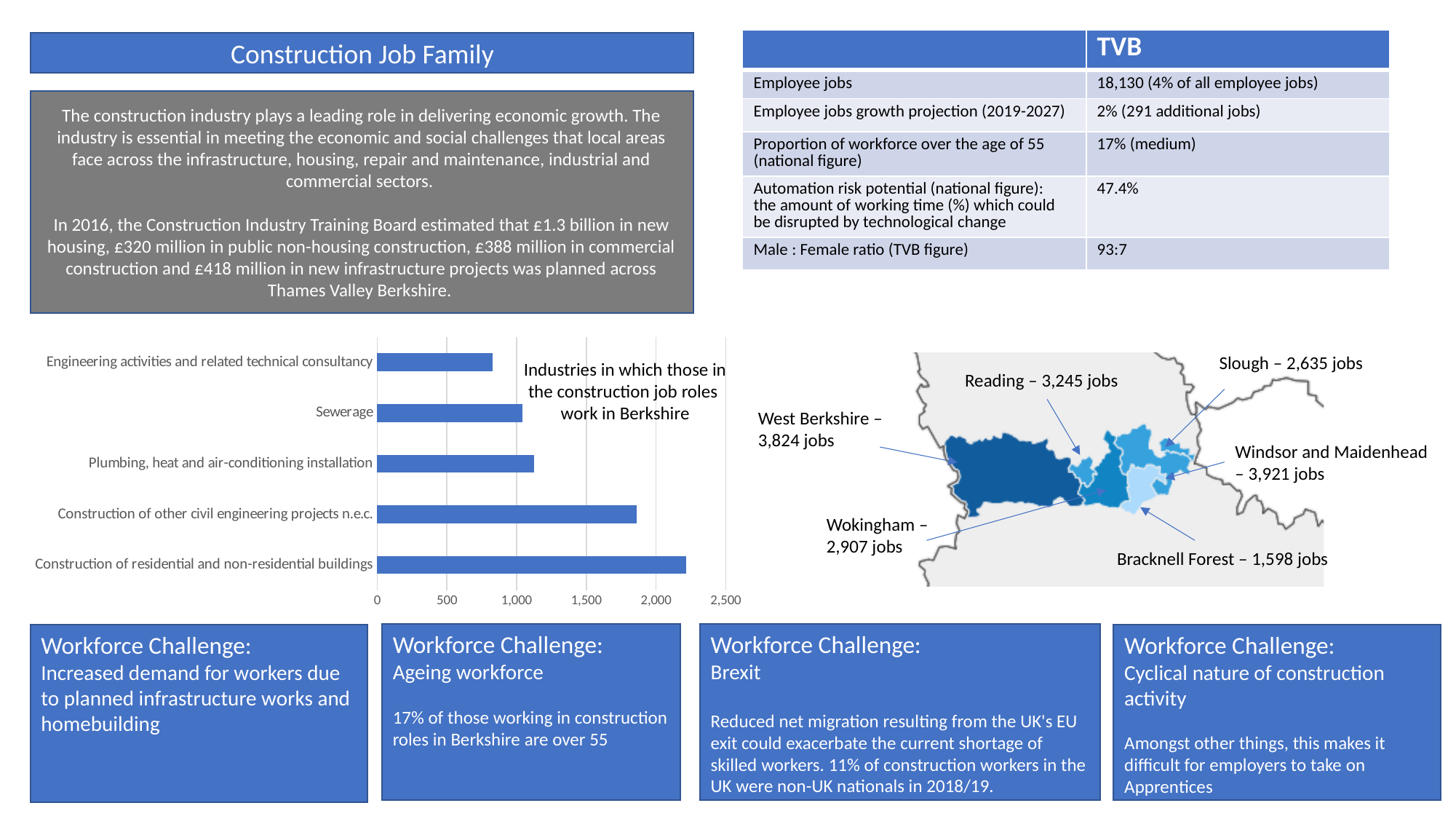
Is the value for Construction of residential and non-residential buildings greater or less than 2,000? greater What kind of chart is shown on the slide? bar chart Is the value for Construction of other civil engineering projects n.e.c. greater or less than 2,000? less Is the value for Engineering activities and related technical consultancy greater or less than 1,000? less How many industry categories are plotted in the bar chart? 5 Which industry has the lowest value in the bar chart? Engineering activities and related technical consultancy What is the title of the bar chart? Industries in which those in the construction job roles work in Berkshire What is the highest tick value shown on the bar chart's horizontal axis? 2,500 Which industry has the highest value in the bar chart? Construction of residential and non-residential buildings Which has the larger value: Engineering activities and related technical consultancy or Construction of residential and non-residential buildings? Construction of residential and non-residential buildings Which has the larger value: Sewerage or Construction of other civil engineering projects n.e.c.? Construction of other civil engineering projects n.e.c.